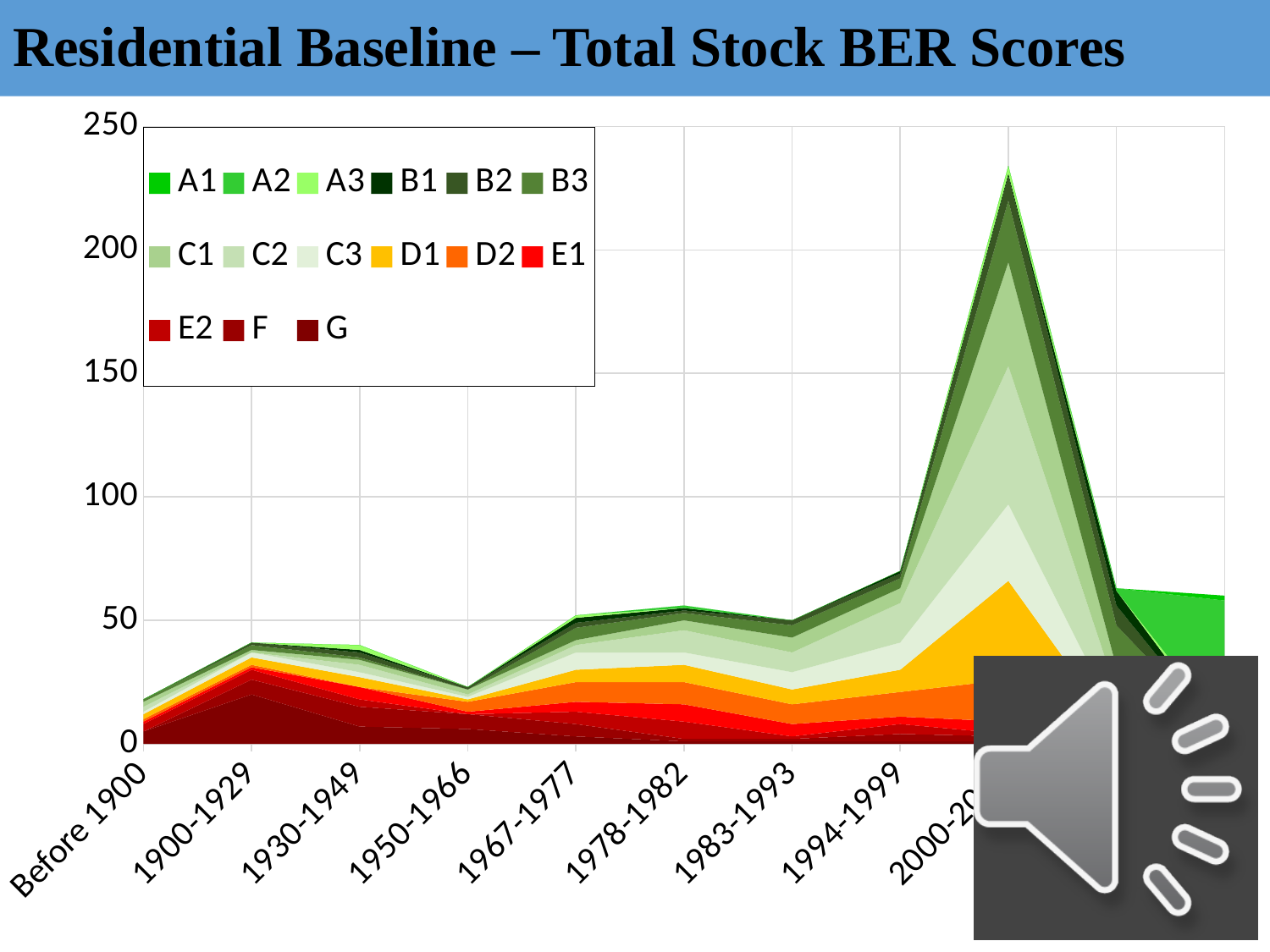
What colour represents series G in the legend? Dark red Is the total stacked value for 1950-1966 greater or less than 50? less What kind of chart is shown on the slide? Stacked area chart Is the peak of the stacked area greater or less than 200? greater Is the total stacked value for 1900-1929 greater or less than 50? less Does the total stacked value rise or fall from 1950-1966 to 1967-1977? rise How many series does the legend list? 15 Which has the larger total stacked value, 1967-1977 or 1950-1966? 1967-1977 What is the title of the slide's chart? Residential Baseline – Total Stock BER Scores Which has the larger total stacked value, Before 1900 or 1900-1929? 1900-1929